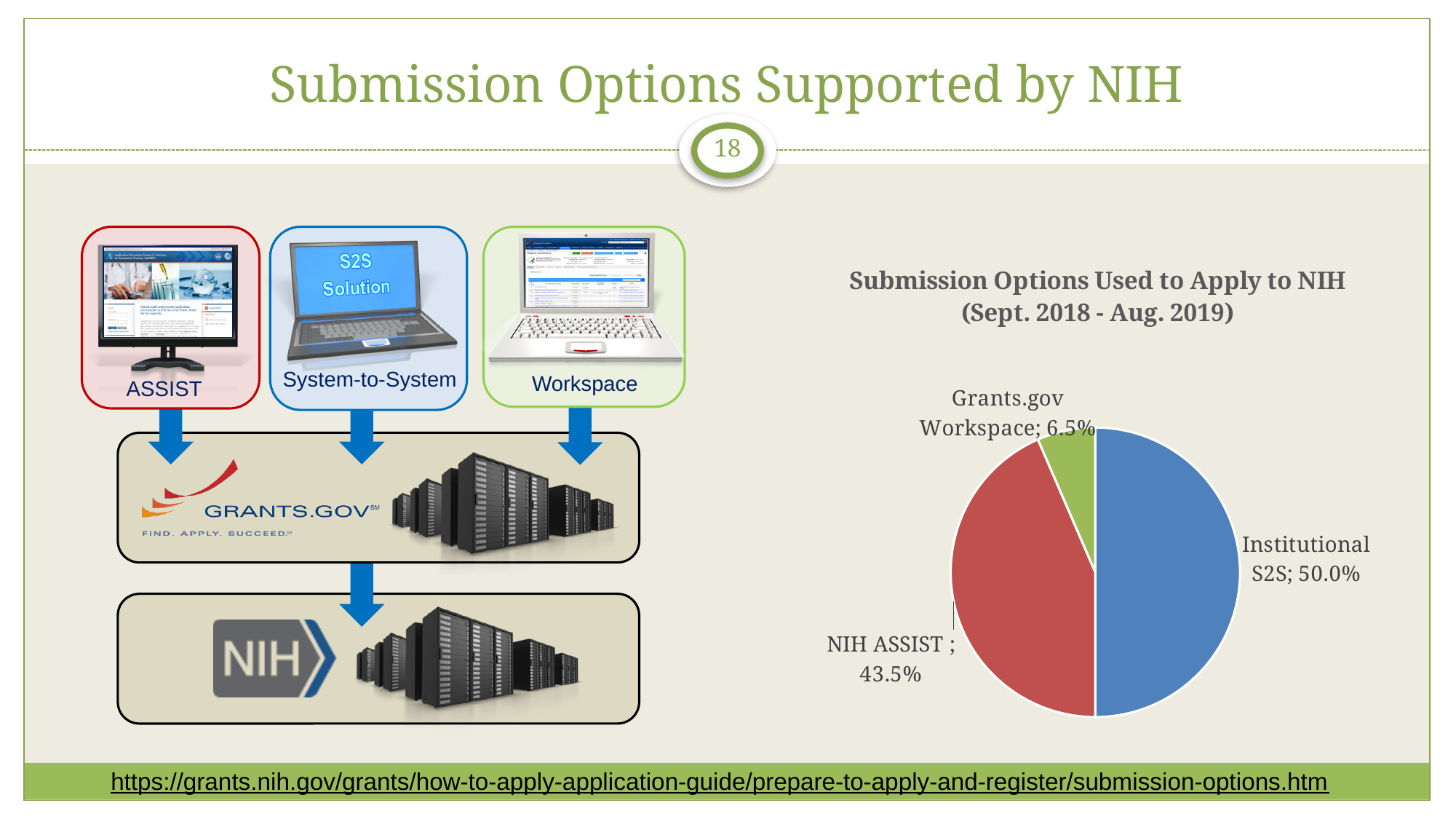
What colour is the Institutional S2S slice? blue What share of the pie does NIH ASSIST have? 43.5% What share of the pie does Institutional S2S have? 50.0% What is the difference between the shares of Institutional S2S and NIH ASSIST? 6.5% What is the title of the chart? Submission Options Used to Apply to NIH (Sept. 2018 - Aug. 2019) What is the difference between the shares of NIH ASSIST and Grants.gov Workspace? 37.0% Which submission option has the largest share? Institutional S2S Which is larger, the share for NIH ASSIST or the share for Grants.gov Workspace? NIH ASSIST How many slices does the pie chart have? 3 What share of the pie does Grants.gov Workspace have? 6.5% Which submission option has the smallest share? Grants.gov Workspace What type of chart is shown on the slide? pie chart